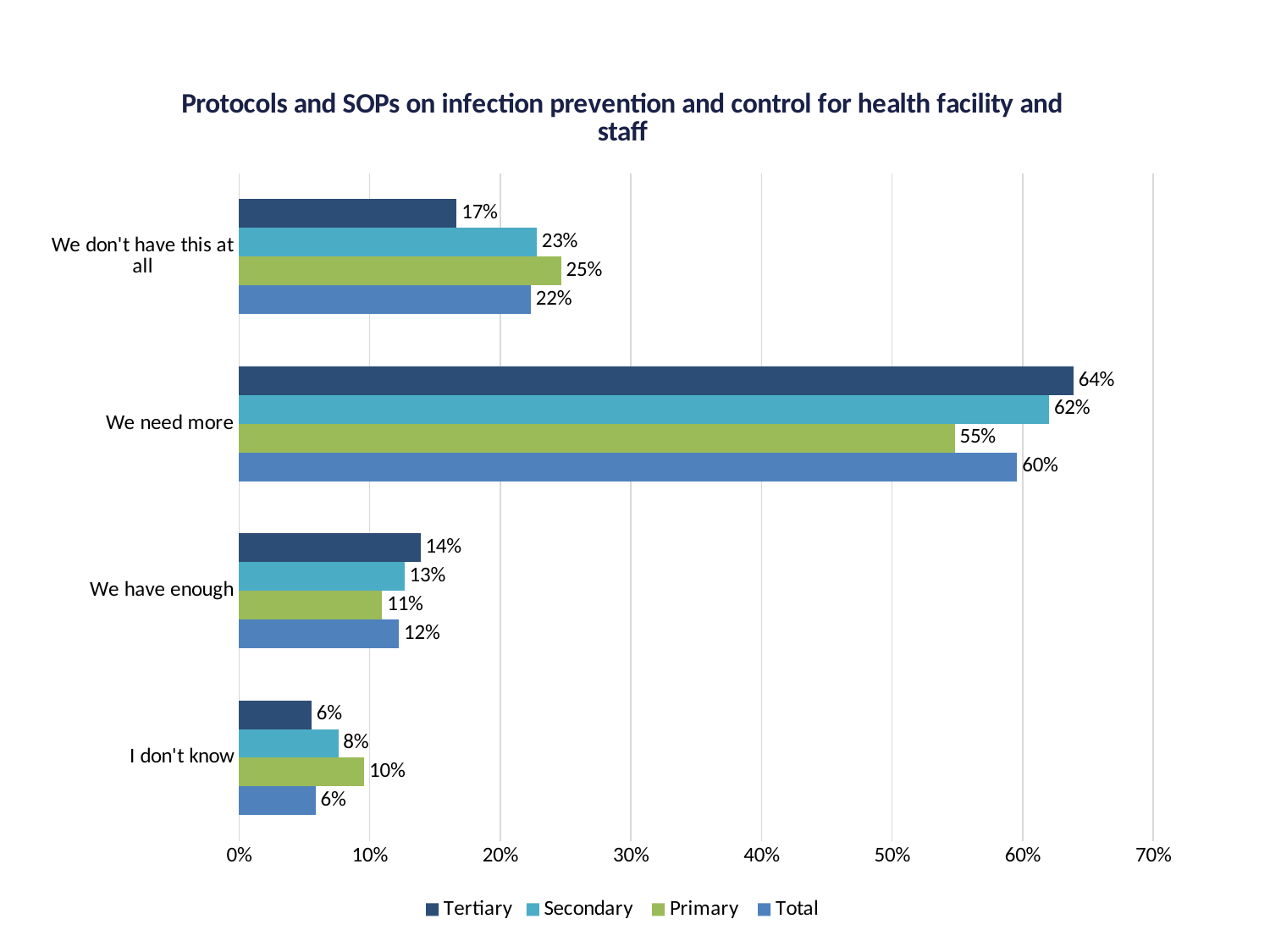
What is the Tertiary value for "We need more"? 64% What is the Total value for "We have enough"? 12% How many categories are shown on the y axis? 4 What is the Primary value for "We don't have this at all"? 25% What kind of chart is shown on the slide? Bar chart Which category has the highest Total value? We need more Is the Total value for "We need more" greater or less than 50%? greater How many series does the legend list? 4 What is the difference between the Tertiary and Primary values for "We need more"? 9% What is the Secondary value for "I don't know"? 8% Which is larger for "I don't know": the Primary value or the Tertiary value? Primary Which category has the lowest Tertiary value? I don't know